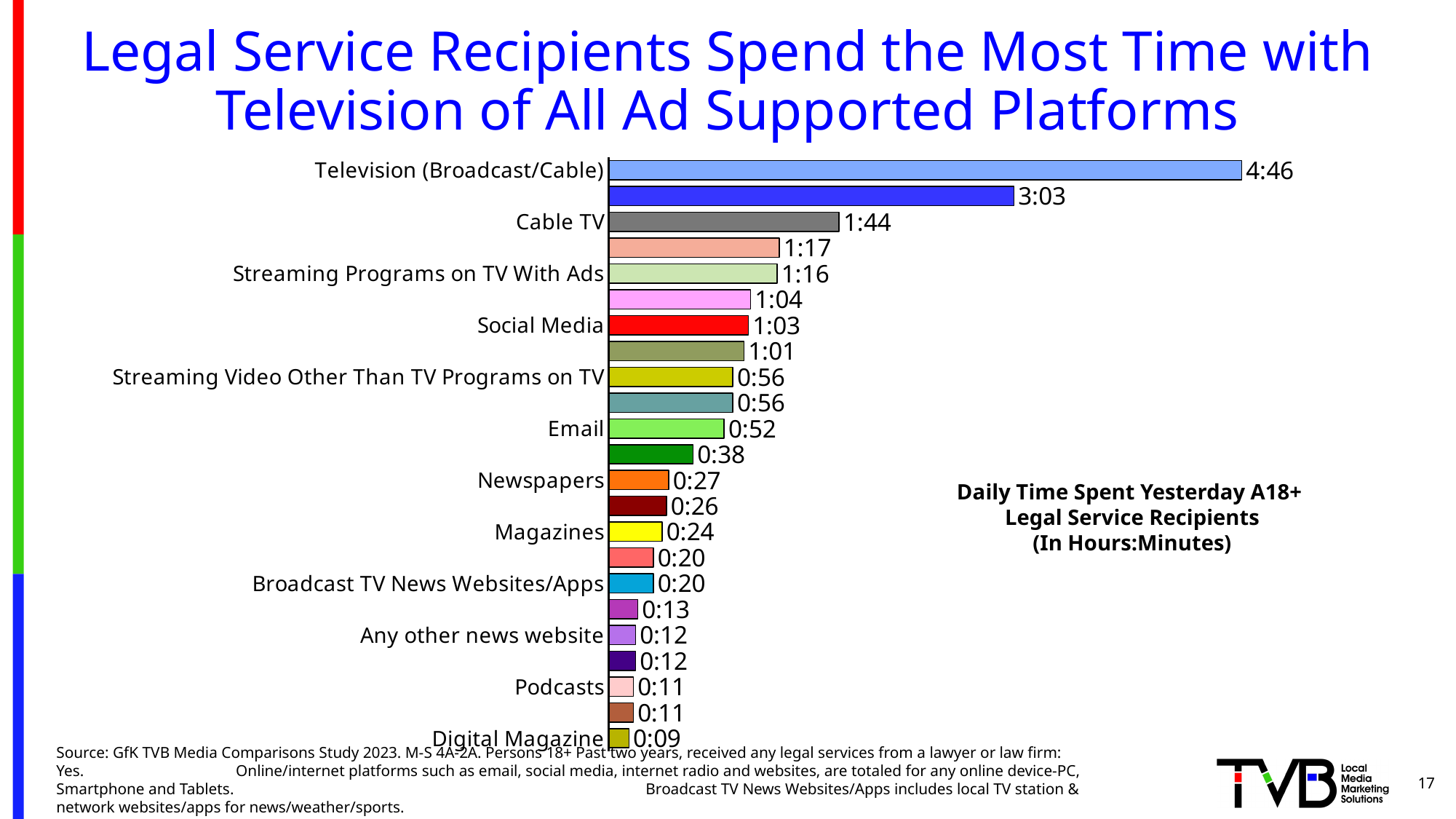
What is the difference between Email and Newspapers? 0:25 What unit does the chart's title say the values are in? Hours:Minutes How much daily time is shown for Social Media? 1:03 Which category has the highest daily time spent? Television (Broadcast/Cable) Which is larger, Streaming Programs on TV With Ads or Social Media? Streaming Programs on TV With Ads What is the value shown for Cable TV? 1:44 What is the difference between Television (Broadcast/Cable) and Cable TV? 3:02 What is the value shown for Digital Magazine? 0:09 What kind of chart is shown on the slide? Bar chart What is the daily time spent with Television (Broadcast/Cable)? 4:46 Which labeled category has the lowest daily time spent? Digital Magazine What is the value for Email? 0:52